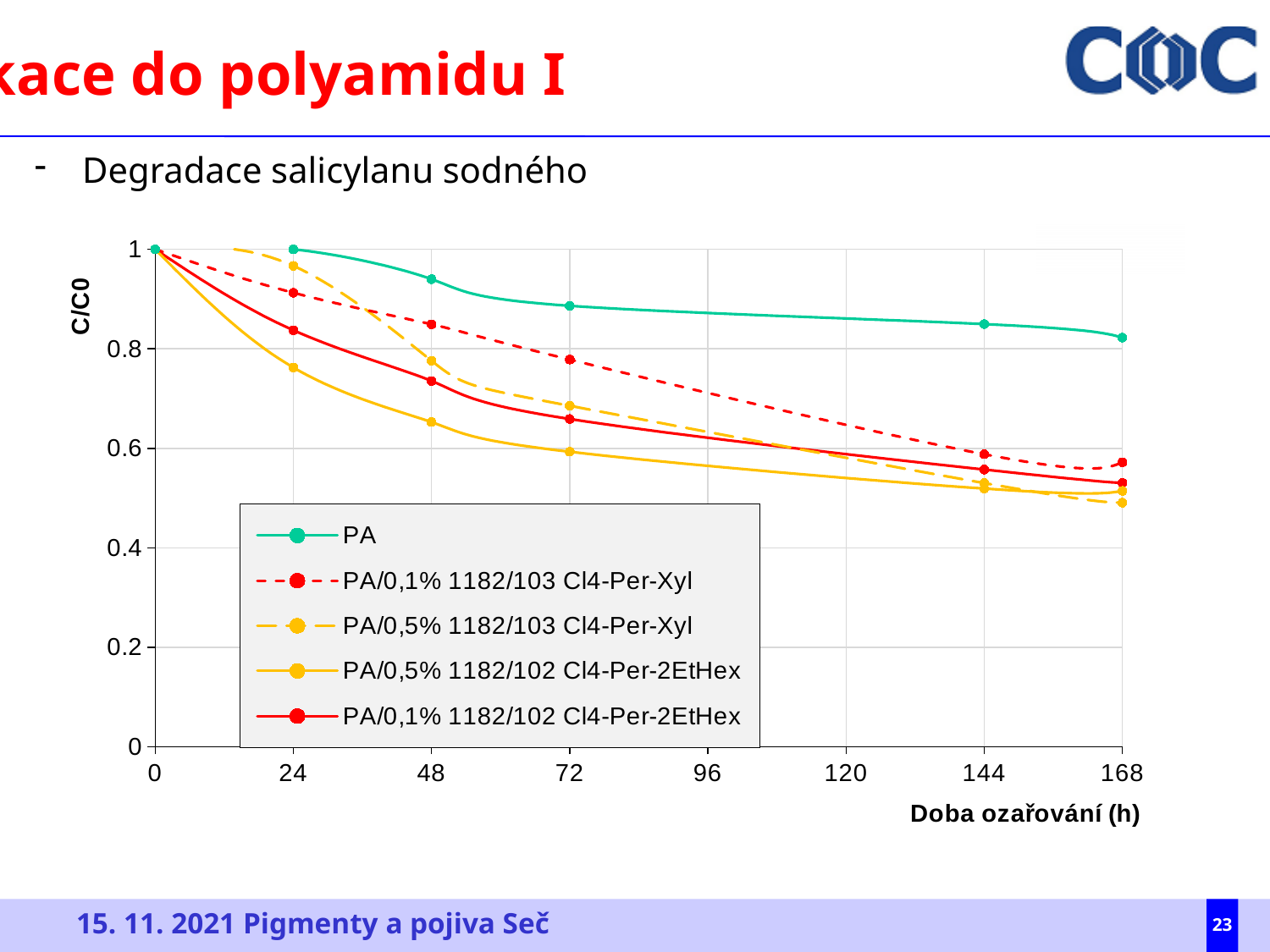
At 48 h, which series has the larger C/C0 value: PA or PA/0,5% 1182/102 Cl4-Per-2EtHex? PA What kind of chart is shown on the slide? line chart What is the C/C0 value of the PA series at 0 h? 1 Do the C/C0 values rise or fall as the irradiation time (Doba ozařování) increases? fall Is the C/C0 value for PA at 168 h greater or less than 0.8? greater Is the C/C0 value for PA/0,5% 1182/102 Cl4-Per-2EtHex at 48 h greater or less than 0.6? greater Which series has the highest C/C0 value at 168 h? PA How many series does the legend list? 5 How many data points are plotted for the PA series? 6 Is the C/C0 value for PA/0,1% 1182/102 Cl4-Per-2EtHex at 48 h greater or less than 0.8? less What is the label of the x axis? Doba ozařování (h) Which series has the lowest C/C0 value at 24 h? PA/0,5% 1182/102 Cl4-Per-2EtHex